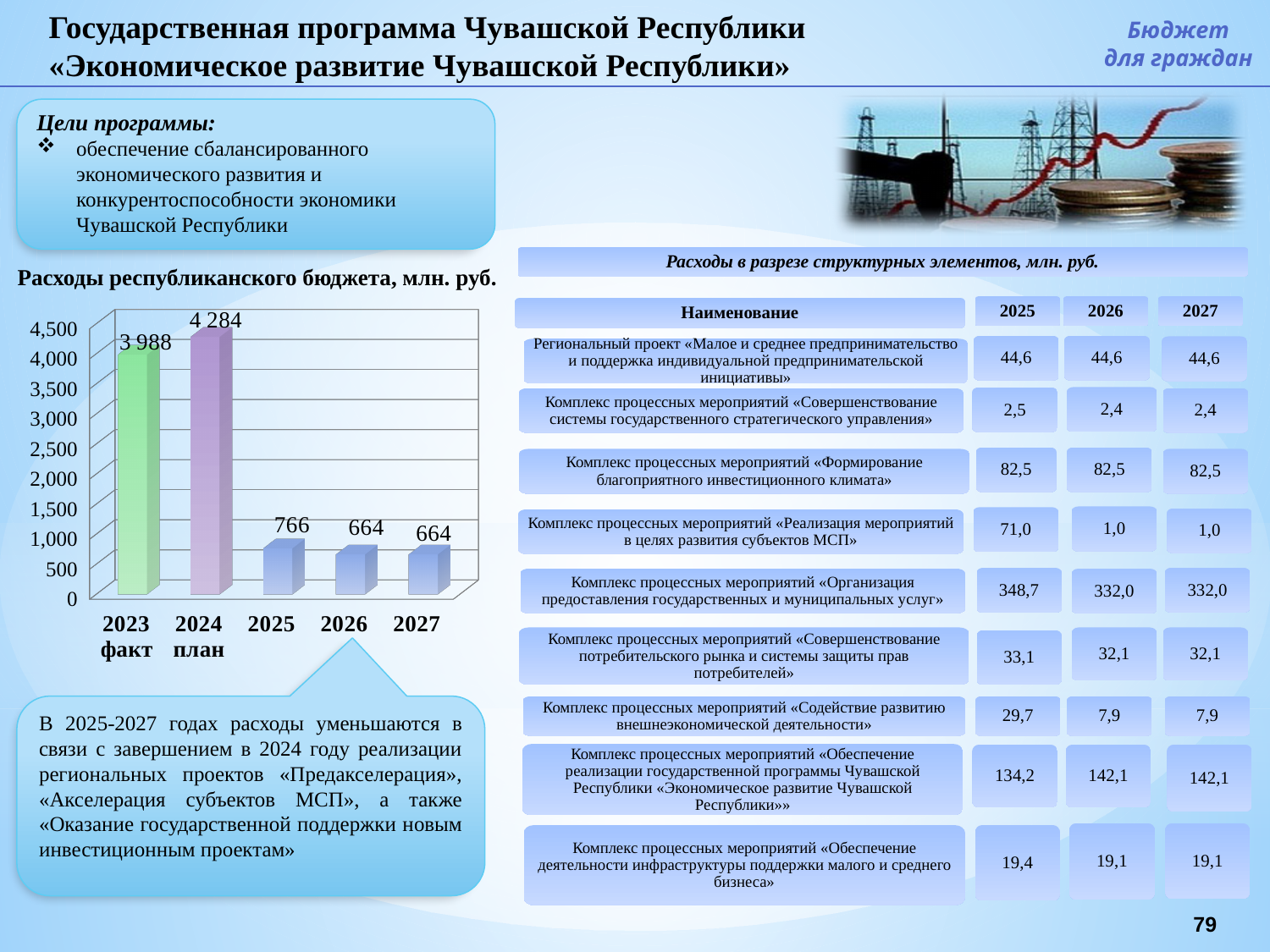
What is the value for 2023 in the chart 'Расходы республиканского бюджета, млн. руб.'? 3 988 Is the value for 2025 in the chart 'Расходы республиканского бюджета, млн. руб.' greater or less than 1,000? less What kind of chart is 'Расходы республиканского бюджета, млн. руб.'? bar chart What is the difference between the values for 2025 and 2026 in the chart 'Расходы республиканского бюджета, млн. руб.'? 102 Which is larger in the chart 'Расходы республиканского бюджета, млн. руб.': the value for 2023 or the value for 2025? 2023 Do the values in the chart 'Расходы республиканского бюджета, млн. руб.' rise or fall from 2024 to 2025? fall What is the value for 2027 in the chart 'Расходы республиканского бюджета, млн. руб.'? 664 What is the difference between the values for 2024 and 2023 in the chart 'Расходы республиканского бюджета, млн. руб.'? 296 What is the value for 2025 in the chart 'Расходы республиканского бюджета, млн. руб.'? 766 What is the value for 2024 in the chart 'Расходы республиканского бюджета, млн. руб.'? 4 284 Which year has the highest value in the chart 'Расходы республиканского бюджета, млн. руб.'? 2024 How many years are shown on the x axis of the chart 'Расходы республиканского бюджета, млн. руб.'? 5